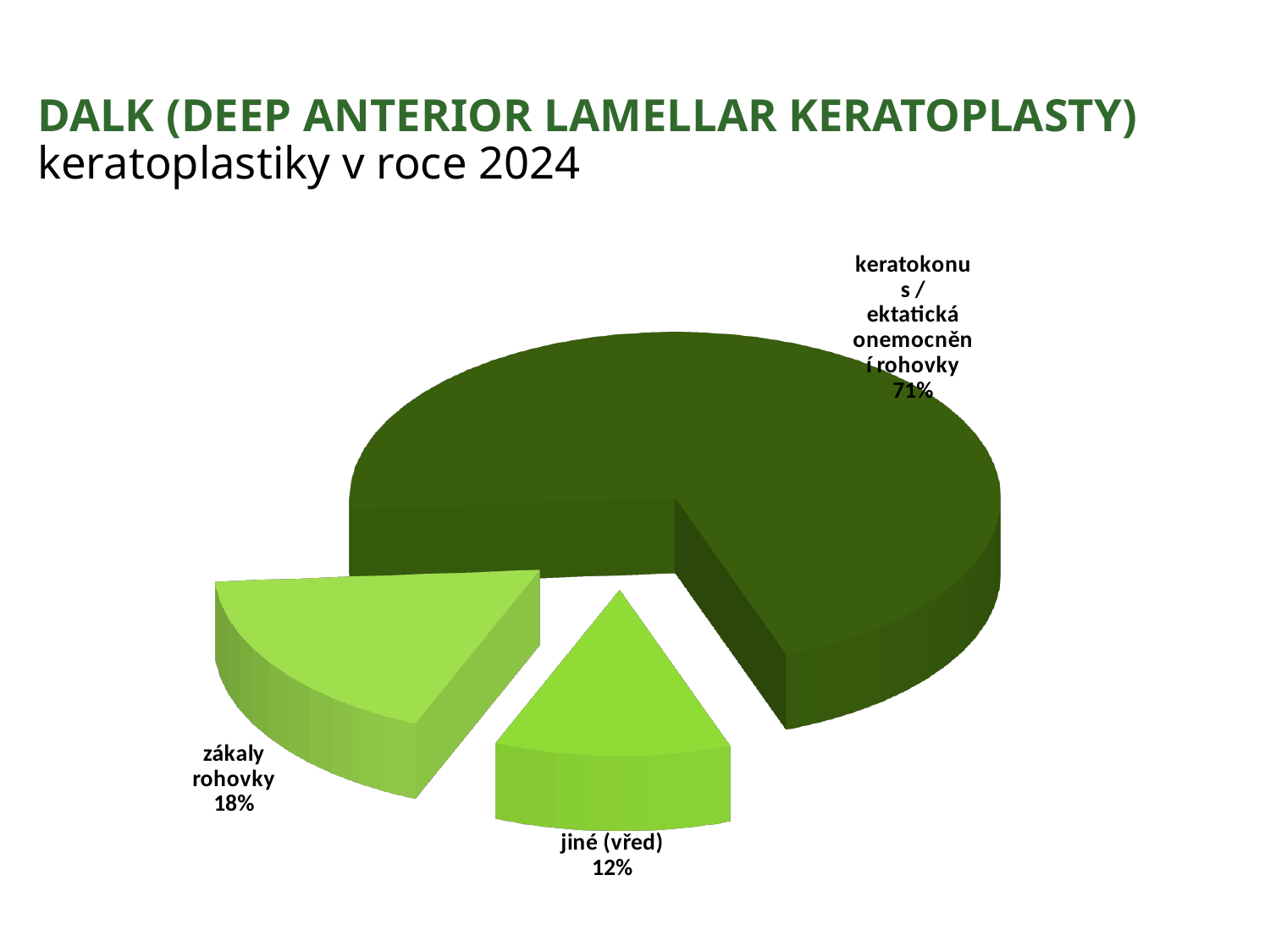
What is the difference in percentage points between the 'keratokonus / ektatická onemocnění rohovky' slice and the 'zákaly rohovky' slice? 53 percentage points What share of the pie is labelled 'zákaly rohovky'? 18% What is the difference in percentage points between the 'zákaly rohovky' slice and the 'jiné (vřed)' slice? 6 percentage points What share of the pie is labelled 'jiné (vřed)'? 12% Which slice of the pie is the smallest? jiné (vřed) How many slices does the pie chart have? 3 Which slice of the pie is drawn in the darkest green? keratokonus / ektatická onemocnění rohovky Which is larger: the 'zákaly rohovky' slice or the 'jiné (vřed)' slice? zákaly rohovky What is the title of the slide containing the pie chart? DALK (DEEP ANTERIOR LAMELLAR KERATOPLASTY) keratoplastiky v roce 2024 What kind of chart is shown on the slide? pie chart Which slice of the pie is the largest? keratokonus / ektatická onemocnění rohovky What share of the pie is labelled 'keratokonus / ektatická onemocnění rohovky'? 71%